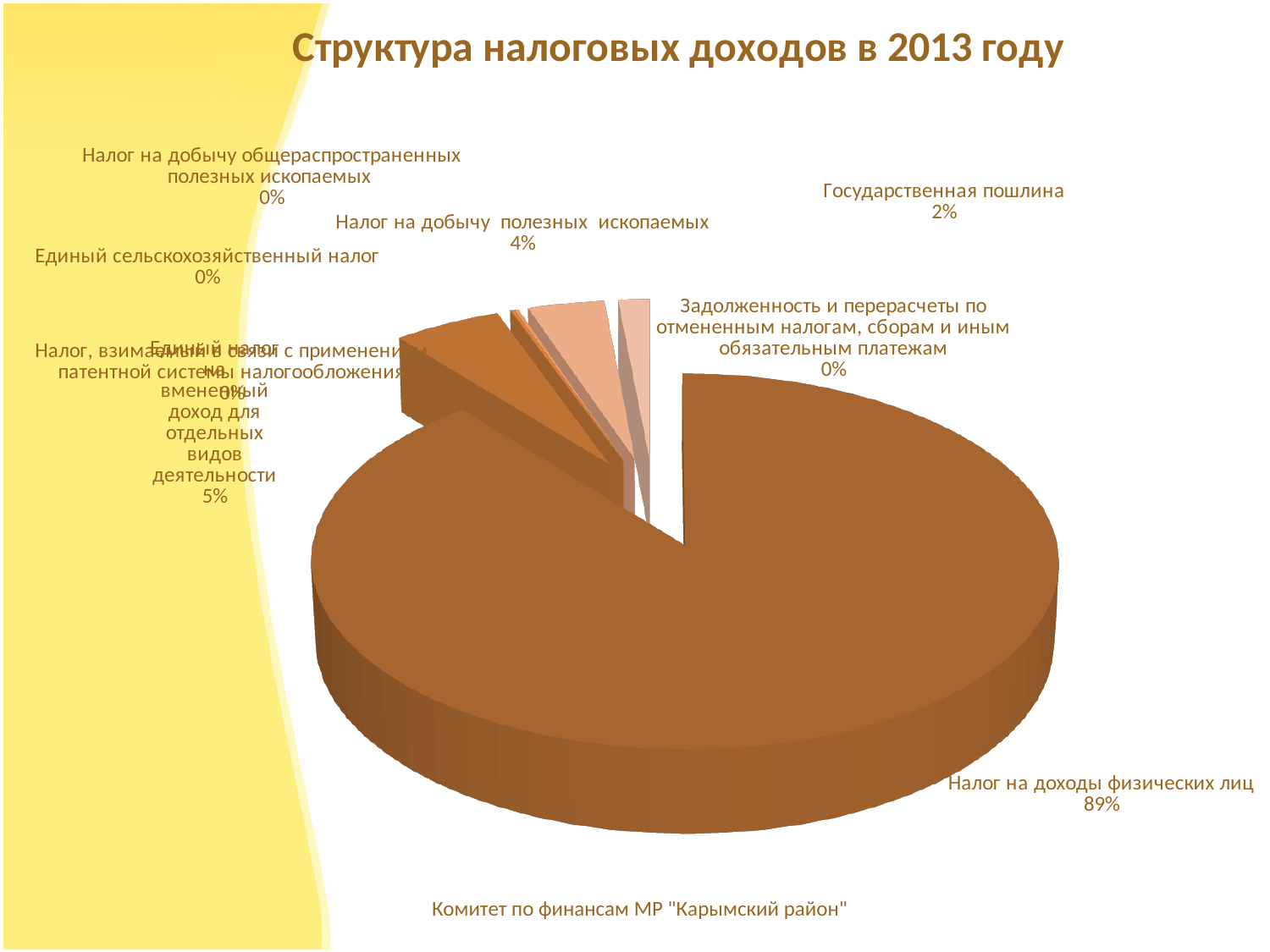
How many categories are labelled on the pie chart? 8 What type of chart is shown on the slide? pie chart Which category has the largest share of the pie? Налог на доходы физических лиц What share is shown for "Единый сельскохозяйственный налог"? 0% What share of tax revenues does "Налог на доходы физических лиц" account for? 89% What share is shown for "Налог на добычу полезных ископаемых"? 4% What is the title of the chart? Структура налоговых доходов в 2013 году Which is larger: the share for "Налог на добычу полезных ископаемых" or for "Государственная пошлина"? Налог на добычу полезных ископаемых What is the difference in percentage points between "Налог на доходы физических лиц" and "Единый налог на вмененный доход для отдельных видов деятельности"? 84 percentage points What organisation is named at the bottom of the slide? Комитет по финансам МР "Карымский район"